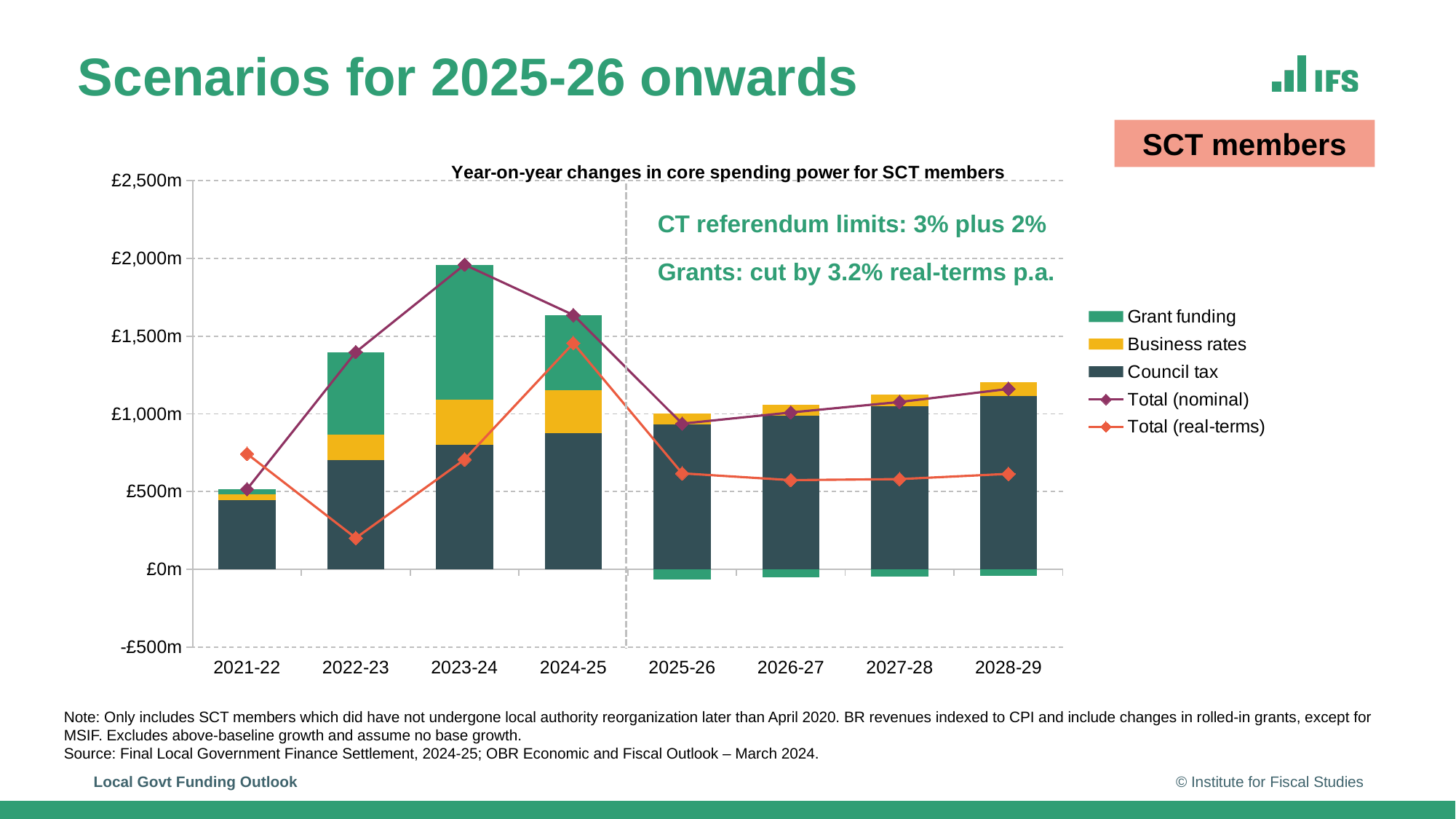
Does Total (nominal) rise or fall from 2025-26 to 2028-29? rise What is the title of the chart? Year-on-year changes in core spending power for SCT members Is the Total (nominal) value for 2023-24 greater or less than £1,500m? greater In which year is Total (real-terms) highest? 2024-25 In which year is Total (real-terms) lowest? 2022-23 Is the Council tax value for 2028-29 greater or less than £1,000m? greater What kind of chart is shown on the slide? combination bar and line chart In which year is Total (nominal) highest? 2023-24 Is the Total (real-terms) value for 2022-23 greater or less than £500m? less How many series does the legend list? 5 Which is larger, Total (nominal) in 2023-24 or in 2024-25? 2023-24 How many years are shown on the x axis? 8